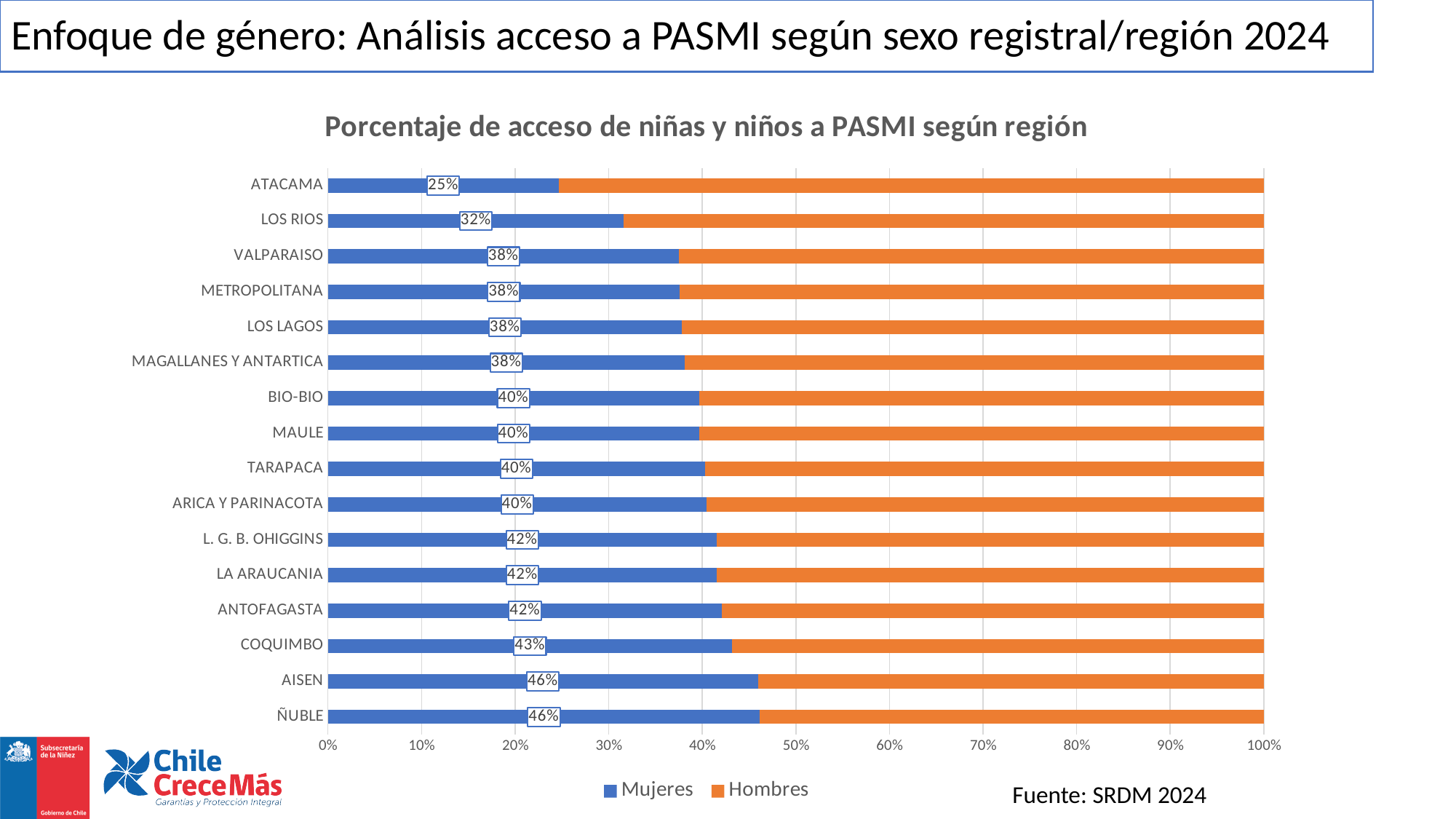
What are the two series named in the legend? Mujeres and Hombres Which region has the lowest Mujeres percentage? ATACAMA What is the Mujeres value for LOS RIOS? 32% What is the difference between the Mujeres value for ÑUBLE and the Mujeres value for ATACAMA? 21% What kind of chart is shown on the slide? Stacked bar chart What is the Mujeres value for ATACAMA? 25% Which has a larger Mujeres value, LOS RIOS or VALPARAISO? VALPARAISO What is the Mujeres value for COQUIMBO? 43% Is the Hombres value for ÑUBLE greater or less than 60%? less How many series does the legend list? 2 How many regions are shown on the chart? 16 Is the Hombres value for ATACAMA greater or less than 70%? greater